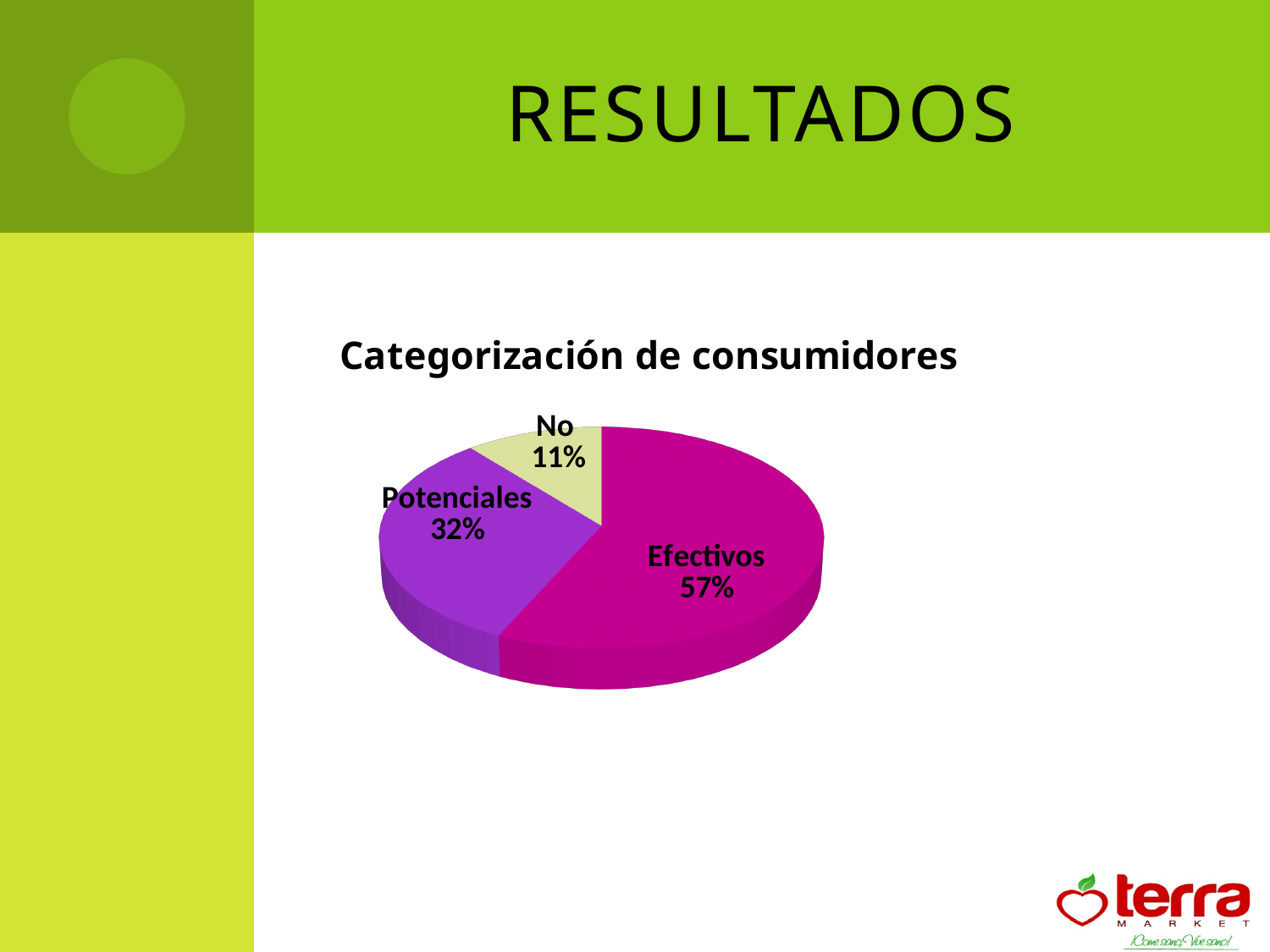
How many slices does the pie chart have? 3 What kind of chart is shown on the slide? pie chart What share of the pie does No represent? 11% Which category has the smallest slice of the pie? No What is the difference in percentage points between Efectivos and Potenciales? 25 Which category has the largest slice of the pie? Efectivos What is the difference in percentage points between Potenciales and No? 21 Which is larger, the Potenciales slice or the No slice? Potenciales What share of the pie does Efectivos represent? 57% What colour is the Efectivos slice? magenta What share of the pie does Potenciales represent? 32% What is the title of the chart? Categorización de consumidores